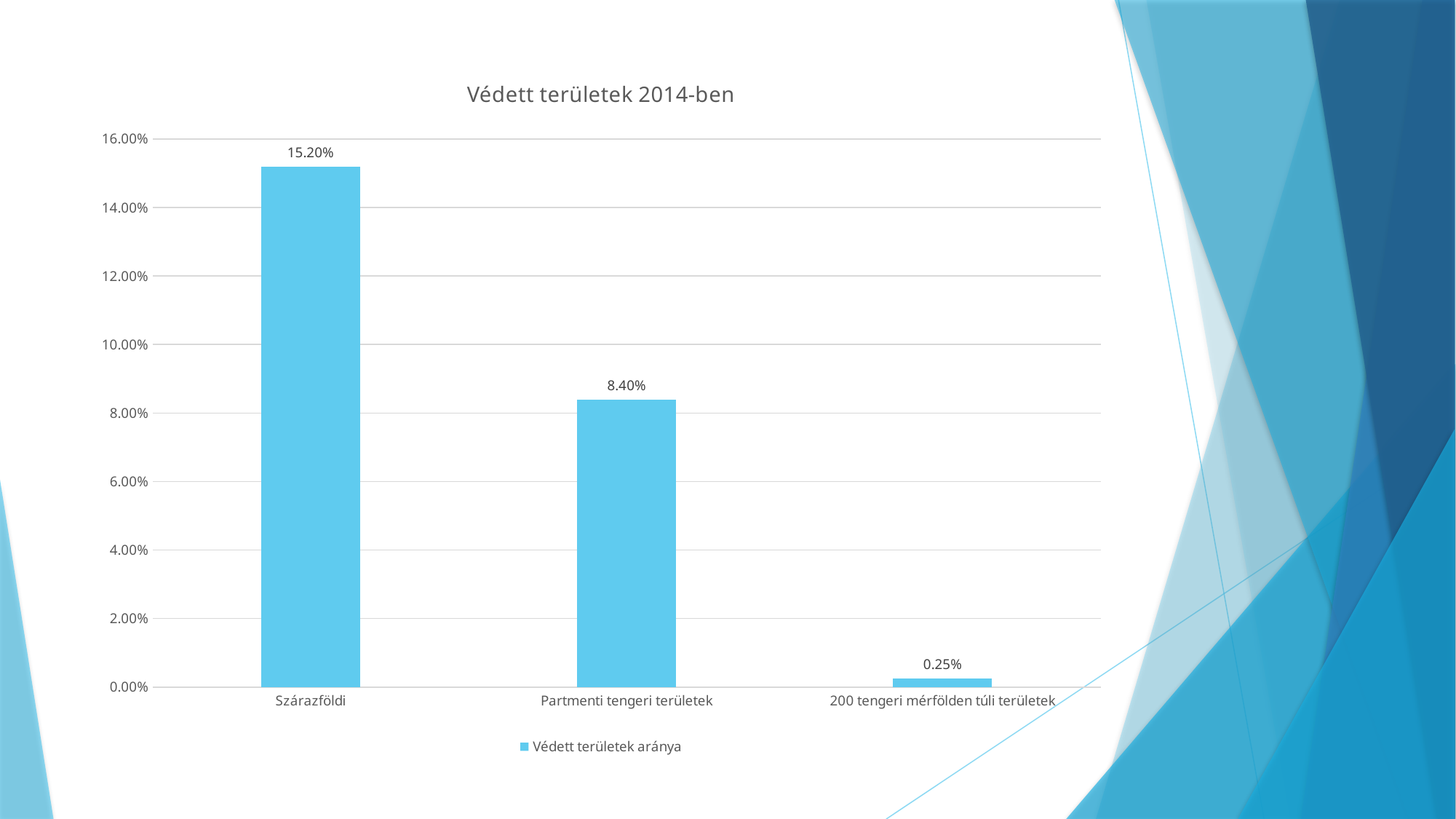
Which category has the lowest value? 200 tengeri mérfölden túli területek Is the value for Partmenti tengeri területek greater or less than 10.00%? less How many series does the legend list? 1 Which category has the highest value? Szárazföldi What is the title of the chart? Védett területek 2014-ben How many categories are shown on the chart? 3 What is the value for Partmenti tengeri területek? 8.40% What kind of chart is shown on the slide? bar chart What is the difference between the values for Szárazföldi and Partmenti tengeri területek? 6.80% What is the value for Szárazföldi? 15.20% What is the value for 200 tengeri mérfölden túli területek? 0.25% Which is larger, the value for Partmenti tengeri területek or the value for 200 tengeri mérfölden túli területek? Partmenti tengeri területek